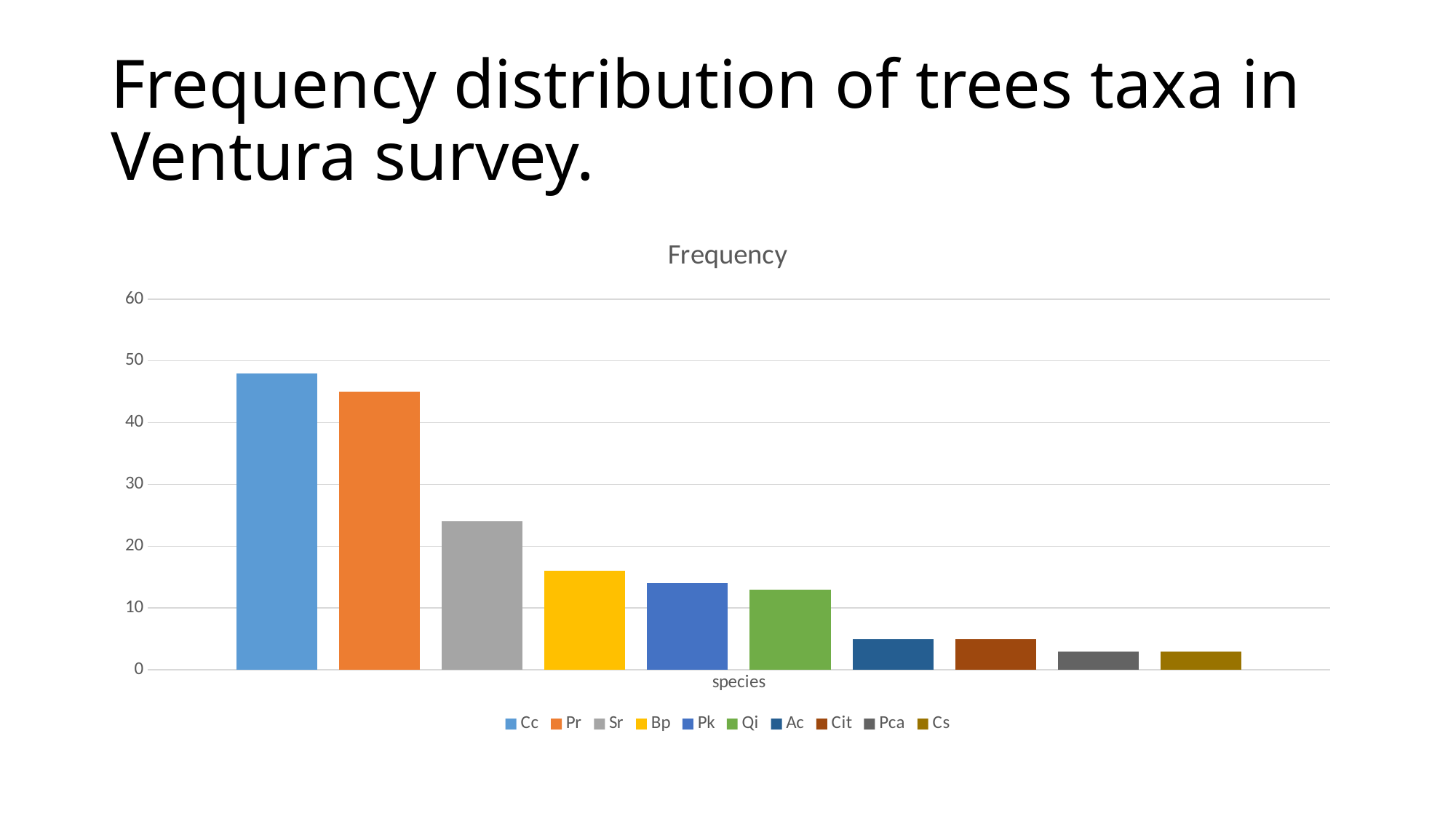
Is the value for Sr greater or less than 20? greater Which has a larger value, Cit or Qi? Qi What kind of chart is shown on the slide? bar chart How many bars are plotted in the chart? 10 Is the value for Ac greater or less than 10? less Which has a larger value, Sr or Bp? Sr How many entries does the legend list? 10 What is the title of the chart? Frequency Is the value for Cc greater or less than 40? greater Which taxon has the highest frequency? Cc Do the bar values rise or fall from left to right across the chart? fall